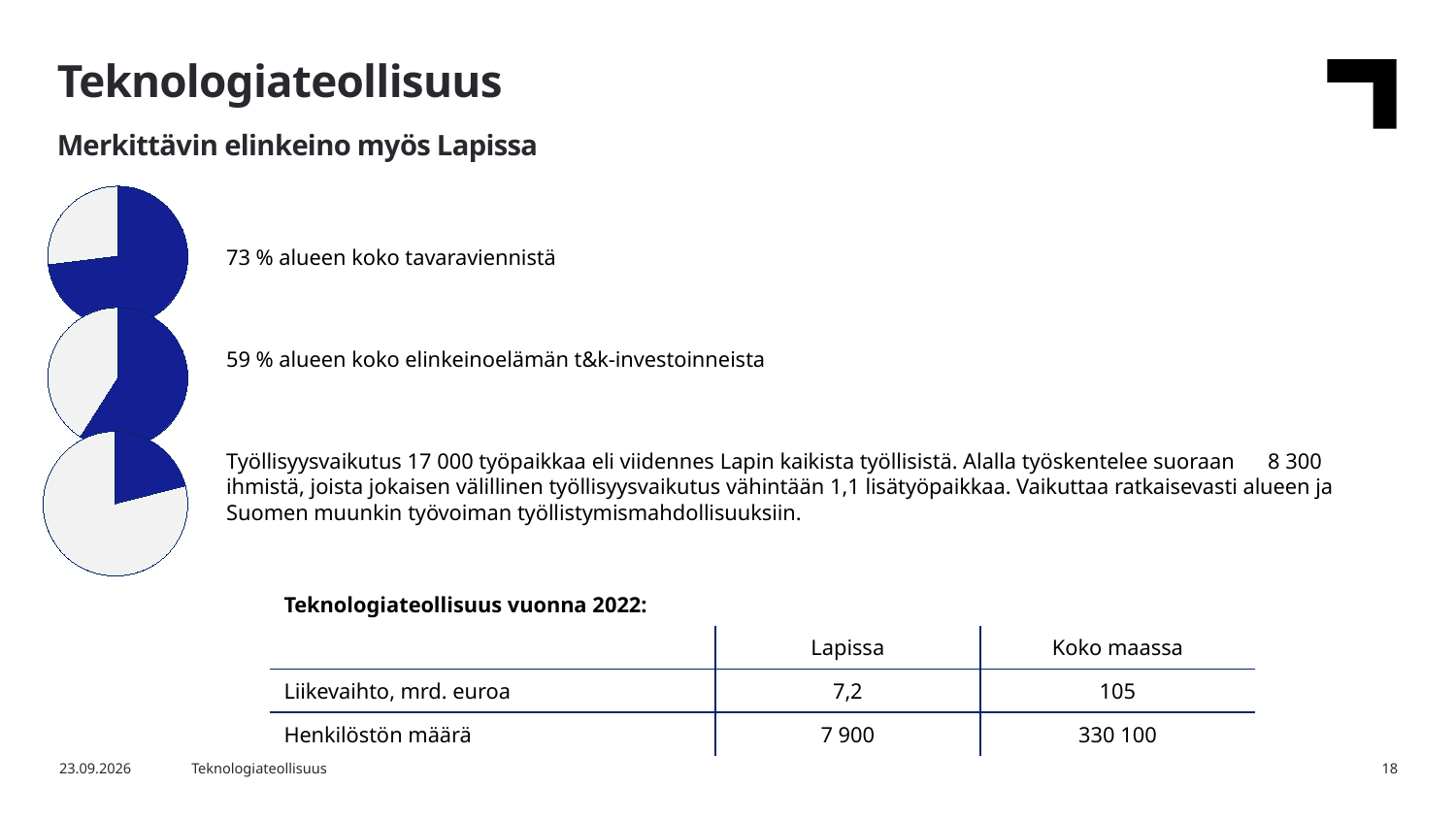
What colour is used for the highlighted slice in the pie charts? Blue According to the text next to the top pie chart, what share of the region's total goods exports does the technology industry account for? 73 % What is the title of the slide containing the pie charts? Teknologiateollisuus Is the blue slice of the bottom pie chart greater or less than 50% of the pie? less Is the blue slice of the top pie chart greater or less than 50% of the pie? greater What is the difference in percentage points between the shares shown for the top pie chart (73 %) and the middle pie chart (59 %)? 14 percentage points What kind of charts are shown on the left side of the slide? Pie charts How many pie charts are on the slide? 3 According to the text next to the middle pie chart, what share of the region's business R&D investments does the technology industry account for? 59 % Is the blue slice of the top pie chart larger or smaller than the blue slice of the middle pie chart? Larger Which pie chart has the largest blue slice: the top, middle or bottom one? Top Which pie chart has the smallest blue slice: the top, middle or bottom one? Bottom